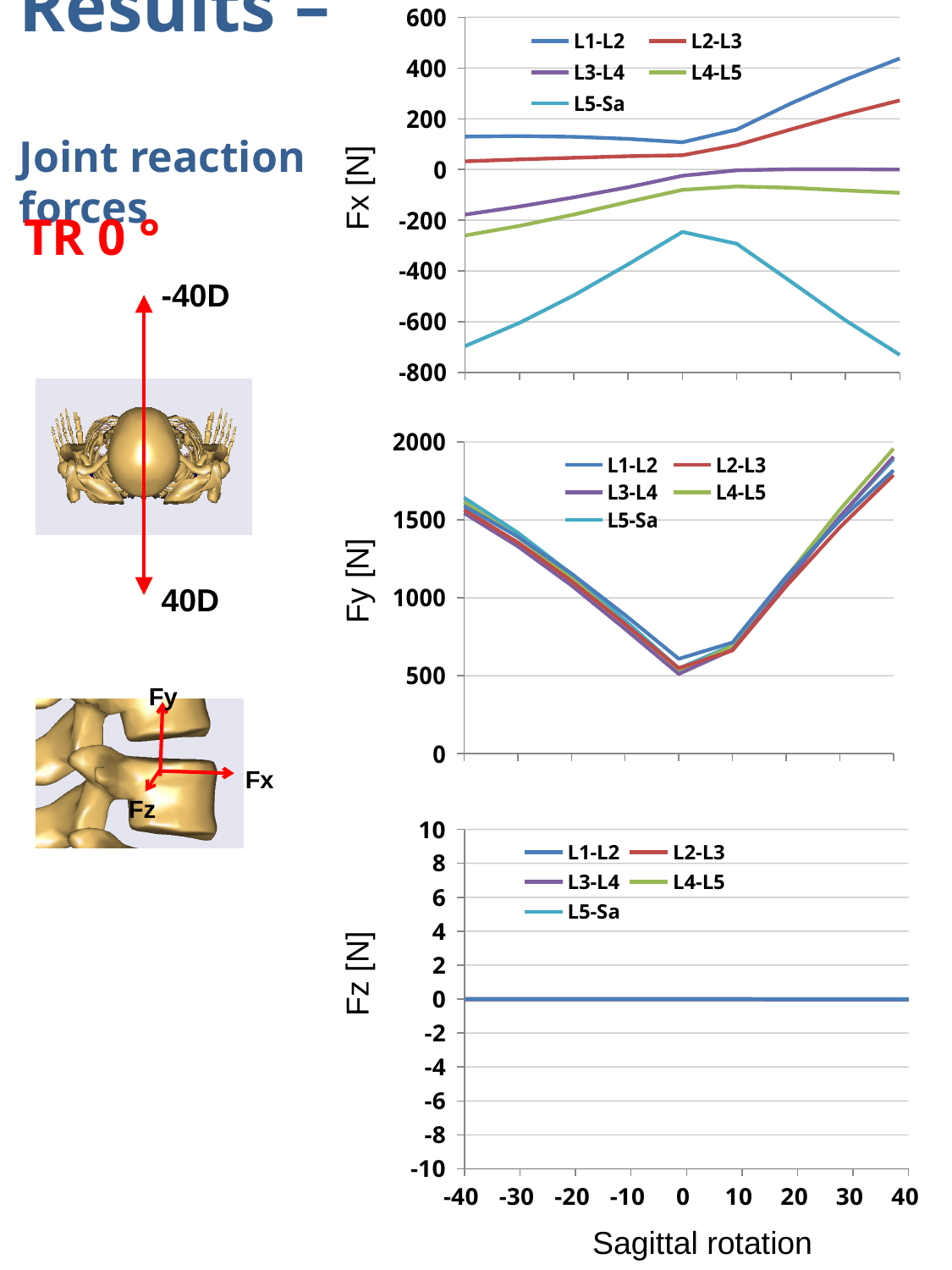
What kind of chart is the Fx [N] chart? line chart In the Fx [N] chart, is the value for L1-L2 at a sagittal rotation of 40 greater or less than 400? greater In the Fx [N] chart, at a sagittal rotation of 40, which is larger: the value for L2-L3 or the value for L4-L5? L2-L3 In the Fz [N] chart, what is the value for L1-L2 at a sagittal rotation of 0? 0 In the Fx [N] chart, is the value for L5-Sa at a sagittal rotation of -40 greater or less than -600? less How many series does the legend of the Fy [N] chart list? 5 What is the label of the x axis shared by the three charts? Sagittal rotation In the Fx [N] chart, which series has the highest value at a sagittal rotation of 40? L1-L2 In the Fy [N] chart, at which sagittal rotation do all series reach their lowest value? 0 In the Fy [N] chart, is the value for L1-L2 at a sagittal rotation of -40 greater or less than 1500? greater In the Fx [N] chart, do the values for L2-L3 rise or fall as sagittal rotation increases from -40 to 40? rise In the Fx [N] chart, which series has the lowest values across the whole range of sagittal rotation? L5-Sa